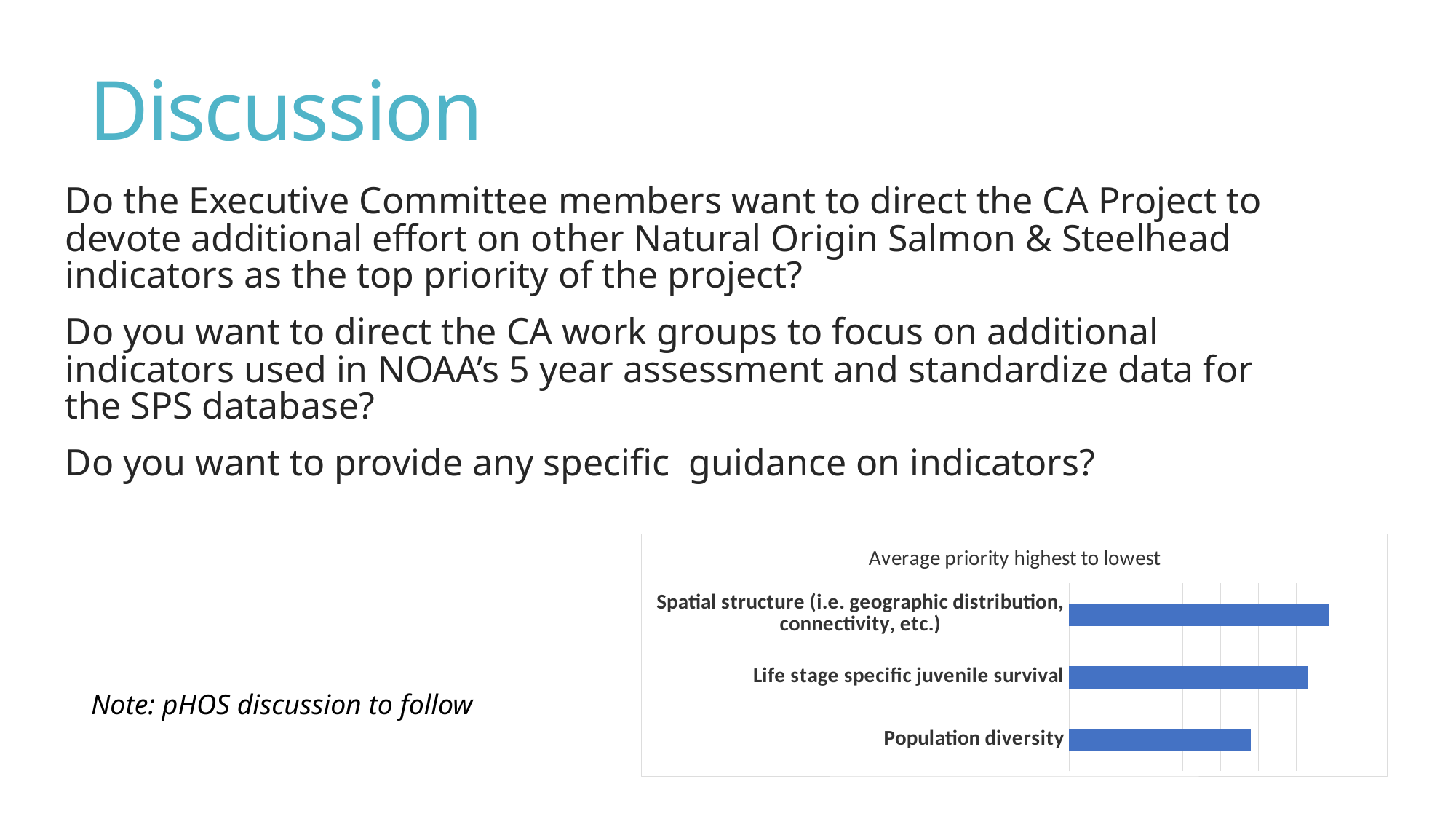
Which category has the shortest bar in the chart? Population diversity Which has the larger value: Life stage specific juvenile survival or Population diversity? Life stage specific juvenile survival Which category is listed at the bottom of the chart? Population diversity How many categories are plotted in the chart? 3 Do the bar lengths increase or decrease going from the top category to the bottom category? decrease Which has the larger value: Spatial structure or Life stage specific juvenile survival? Spatial structure What is the title of the chart on the slide? Average priority highest to lowest Which category has the longest bar in the chart? Spatial structure (i.e. geographic distribution, connectivity, etc.) What colour are the bars in the chart? blue What kind of chart is shown on the slide? bar chart